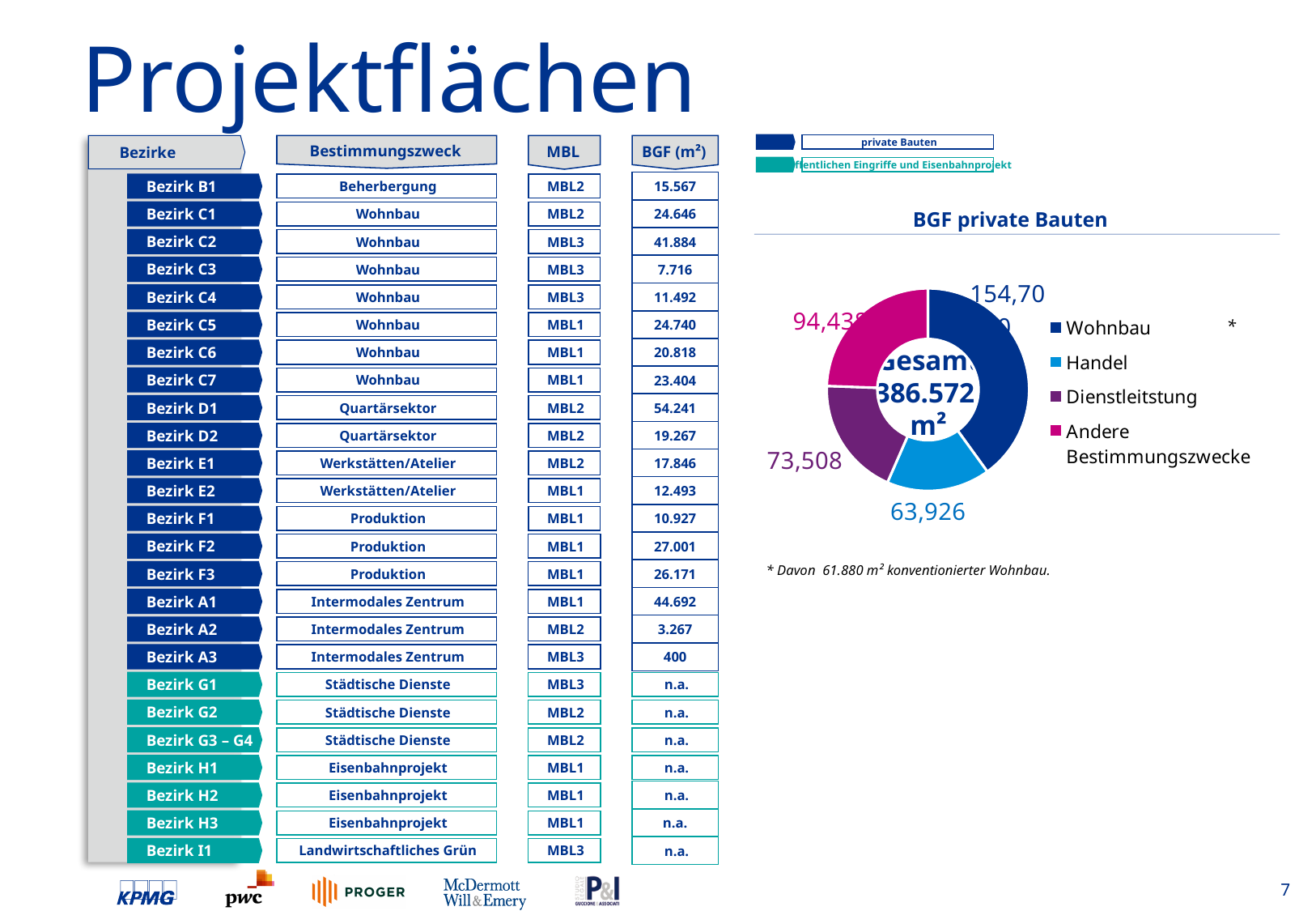
In the 'BGF private Bauten' chart, what is the value for Handel? 63,926 In the 'BGF private Bauten' chart, which category has the largest share? Wohnbau In the 'BGF private Bauten' chart, what is the difference between the values for Dienstleistung and Handel? 9,582 How many categories does the 'BGF private Bauten' chart show? 4 In the 'BGF private Bauten' chart, which category has the smallest share? Handel In the 'BGF private Bauten' chart, which category is shown in magenta/pink? Andere Bestimmungszwecke What is the title of the chart on the right side of the slide? BGF private Bauten What total is printed in the centre of the 'BGF private Bauten' chart? Gesamt 386.572 m² In the 'BGF private Bauten' chart, which is larger: Wohnbau or Andere Bestimmungszwecke? Wohnbau What kind of chart is 'BGF private Bauten'? Doughnut (pie) chart In the 'BGF private Bauten' chart, what is the value for Dienstleistung? 73,508 In the 'BGF private Bauten' chart, which is larger: Dienstleistung or Handel? Dienstleistung